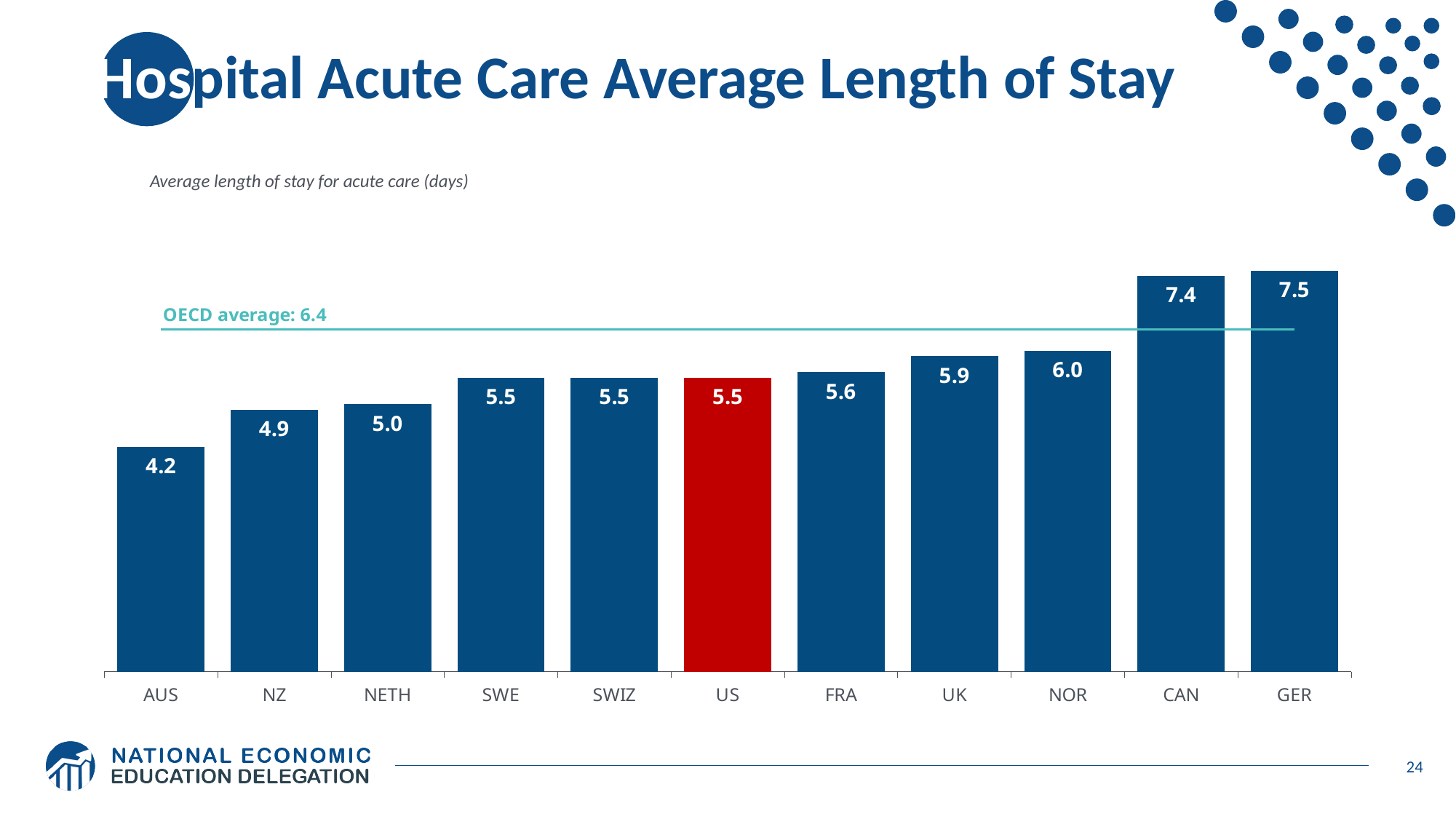
What is the average length of stay for acute care in Australia (AUS)? 4.2 What is the difference in average length of stay between CAN and AUS? 3.2 Which country's bar is highlighted in red? US Which country has the lowest average length of stay for acute care? AUS How many countries are shown in the chart? 11 What is the average length of stay for acute care in the US? 5.5 What is the average length of stay for acute care in Germany (GER)? 7.5 What is the OECD average shown on the chart? 6.4 Do the values rise or fall from left to right across the x axis? Rise Which has a longer average length of stay, NOR or NETH? NOR Which country has the highest average length of stay for acute care? GER What type of chart is shown on the slide? Bar chart